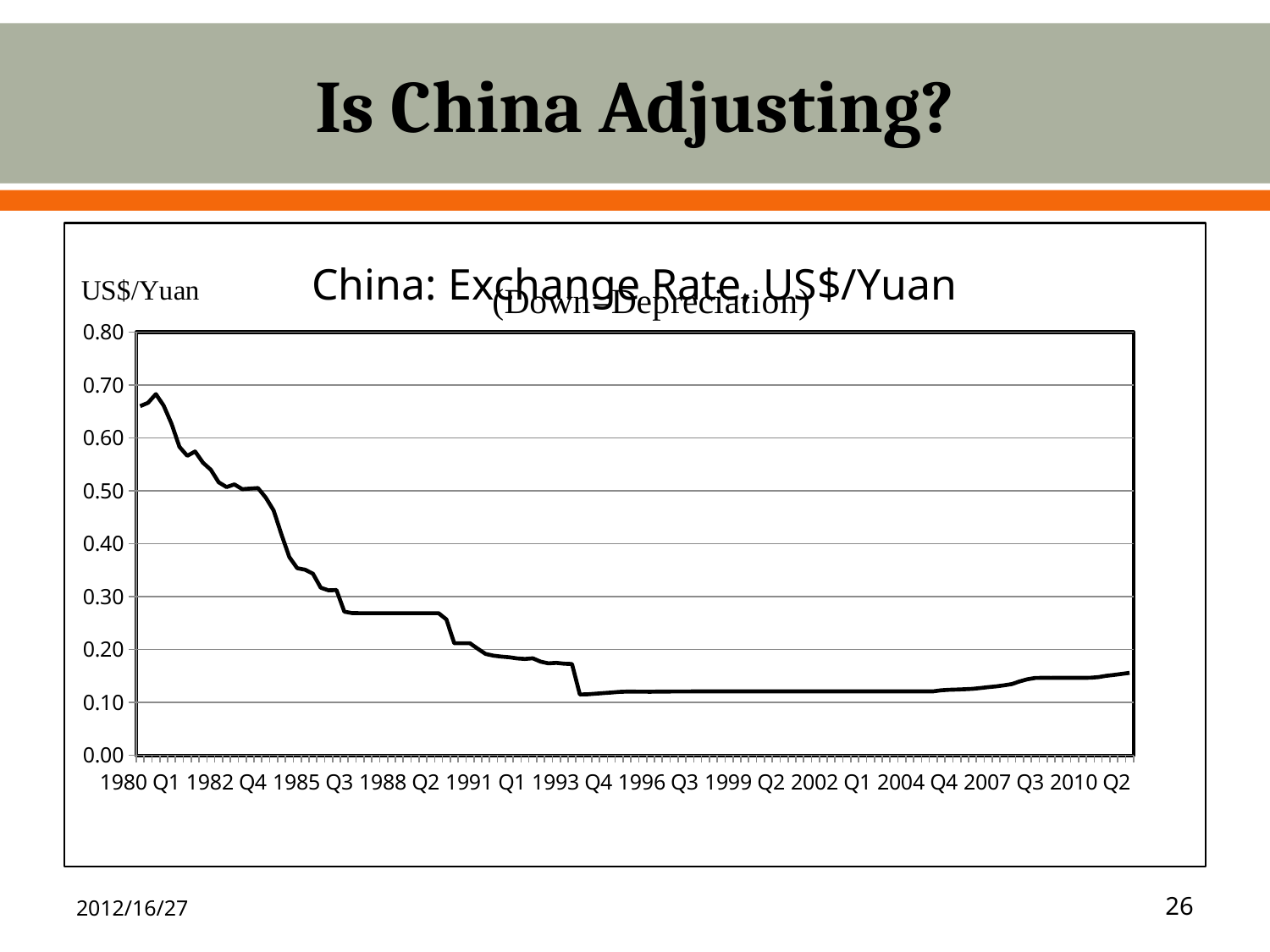
What unit label is shown on the vertical axis of the chart? US$/Yuan Is the value for 2010 Q2 greater or less than 0.20? less Does the exchange rate generally rise or fall from 1980 Q1 to 2010 Q2? fall Is the value for 1996 Q3 greater or less than 0.20? less Is the value for 1980 Q1 greater or less than 0.60? greater What kind of chart is shown on the slide? line chart What is the title of the chart? China: Exchange Rate, US$/Yuan How many data series are plotted on the chart? 1 Which is larger, the value for 1980 Q1 or the value for 2010 Q2? 1980 Q1 Which is larger, the value for 1985 Q3 or the value for 1999 Q2? 1985 Q3